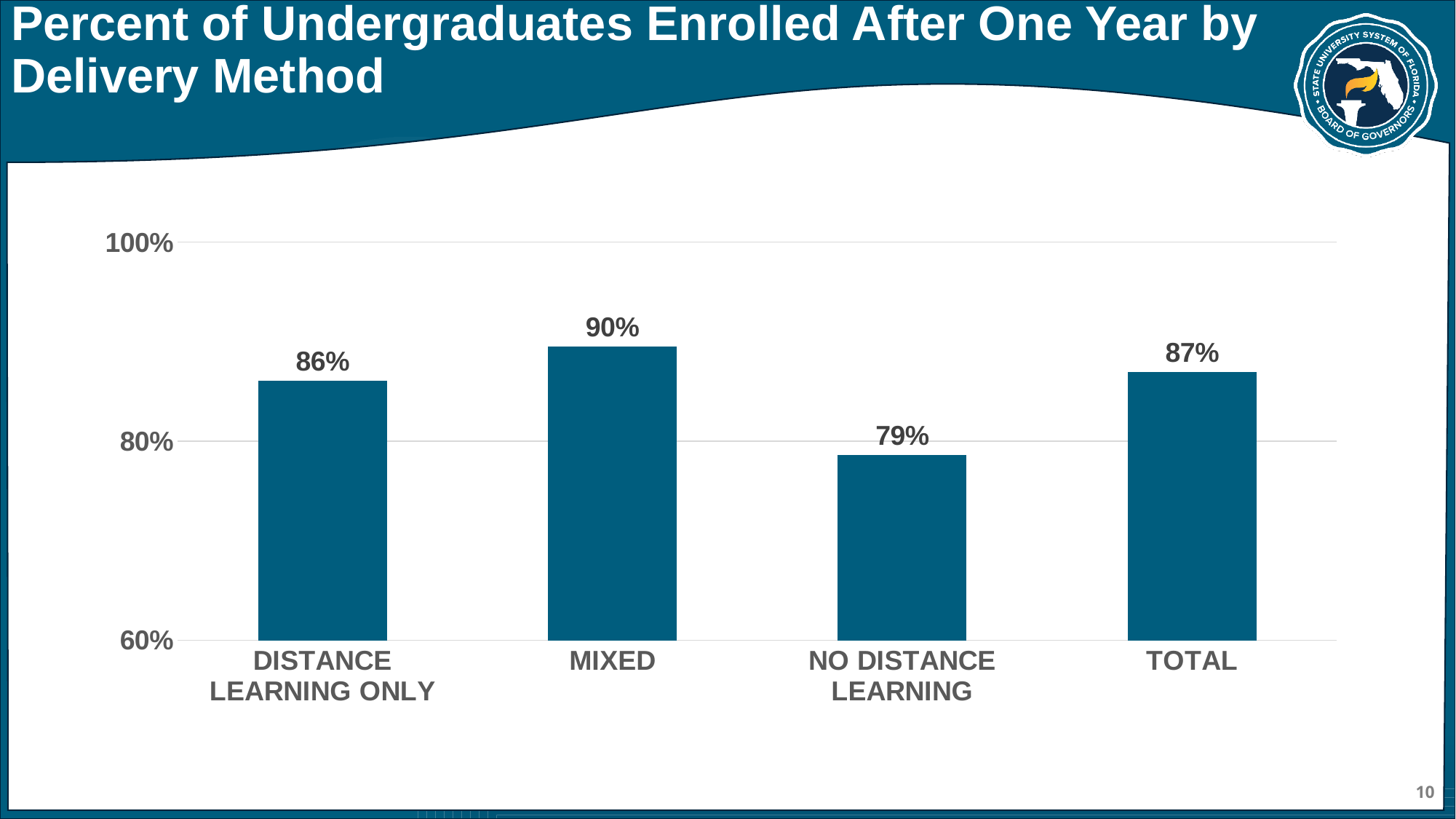
Which category has the highest value? Mixed How many categories are shown on the chart? 4 What is the value for Mixed? 90% What is the value for Total? 87% Which category has the lowest value? No Distance Learning What is the value for Distance Learning Only? 86% What is the difference between the values for Total and Distance Learning Only? 1% What is the difference between the values for Mixed and No Distance Learning? 11% Is the value for No Distance Learning greater or less than 80%? less What kind of chart is shown on the slide? bar chart Which is larger, the value for Distance Learning Only or the value for No Distance Learning? Distance Learning Only What is the value for No Distance Learning? 79%